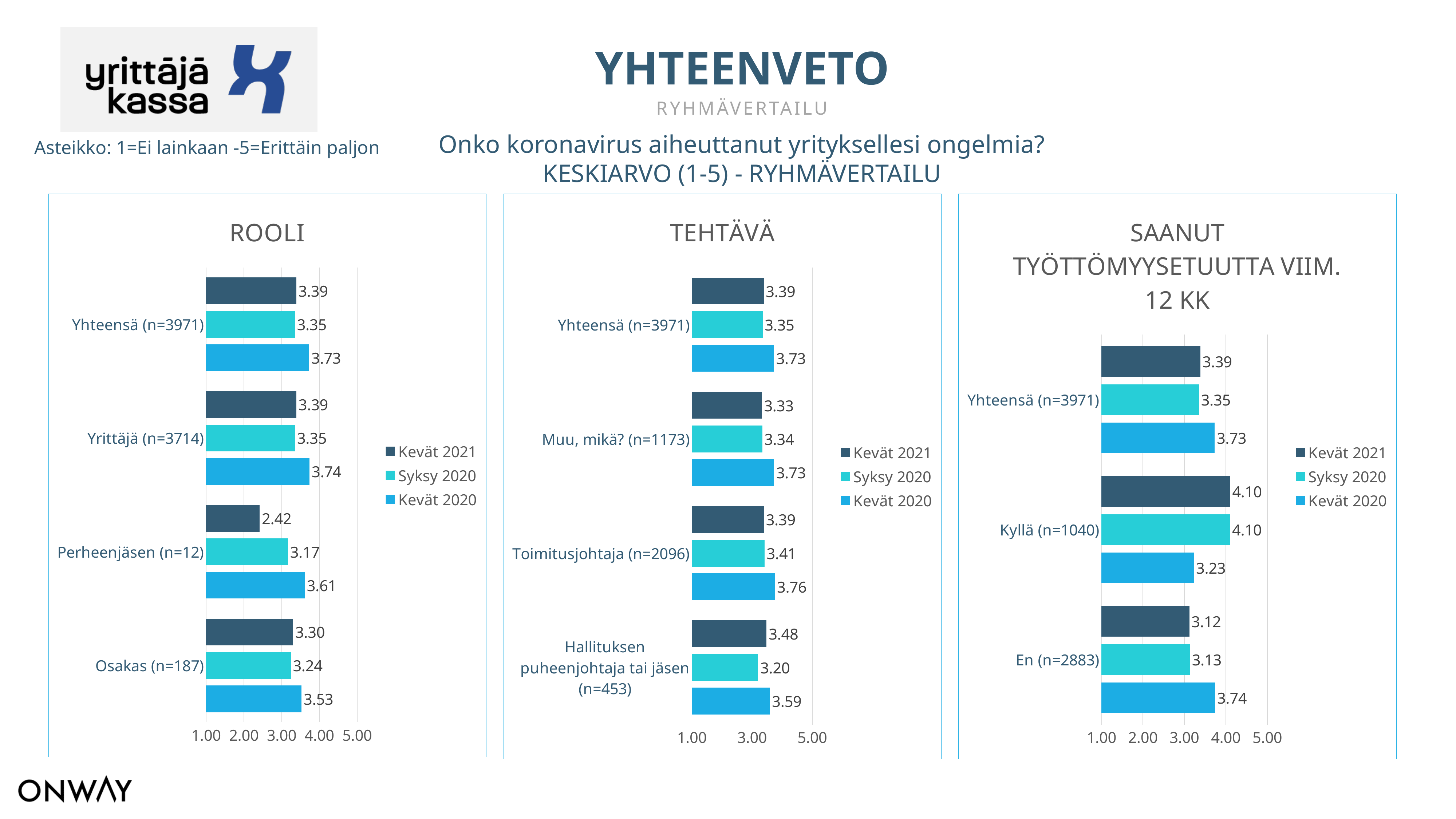
How many series does the legend of the ROOLI chart list? 3 In the TEHTÄVÄ chart, which is larger for Toimitusjohtaja (n=2096): the Kevät 2021 value or the Kevät 2020 value? Kevät 2020 In the ROOLI chart, what is the Kevät 2020 value for Yrittäjä (n=3714)? 3.74 In the ROOLI chart, what is the Kevät 2021 value for Perheenjäsen (n=12)? 2.42 In the TEHTÄVÄ chart, which category has the highest Kevät 2020 value? Toimitusjohtaja (n=2096) What kind of chart is the SAANUT TYÖTTÖMYYSETUUTTA VIIM. 12 KK chart? Bar chart In the SAANUT TYÖTTÖMYYSETUUTTA VIIM. 12 KK chart, what is the difference between the Kevät 2020 and Kevät 2021 values for En (n=2883)? 0.62 In the ROOLI chart, what is the difference between the Kevät 2020 and Kevät 2021 values for Perheenjäsen (n=12)? 1.19 How many categories are shown in the TEHTÄVÄ chart? 4 In the TEHTÄVÄ chart, what is the Syksy 2020 value for Hallituksen puheenjohtaja tai jäsen (n=453)? 3.20 In the SAANUT TYÖTTÖMYYSETUUTTA VIIM. 12 KK chart, what is the Kevät 2021 value for Kyllä (n=1040)? 4.10 In the ROOLI chart, which category has the lowest Kevät 2021 value? Perheenjäsen (n=12)